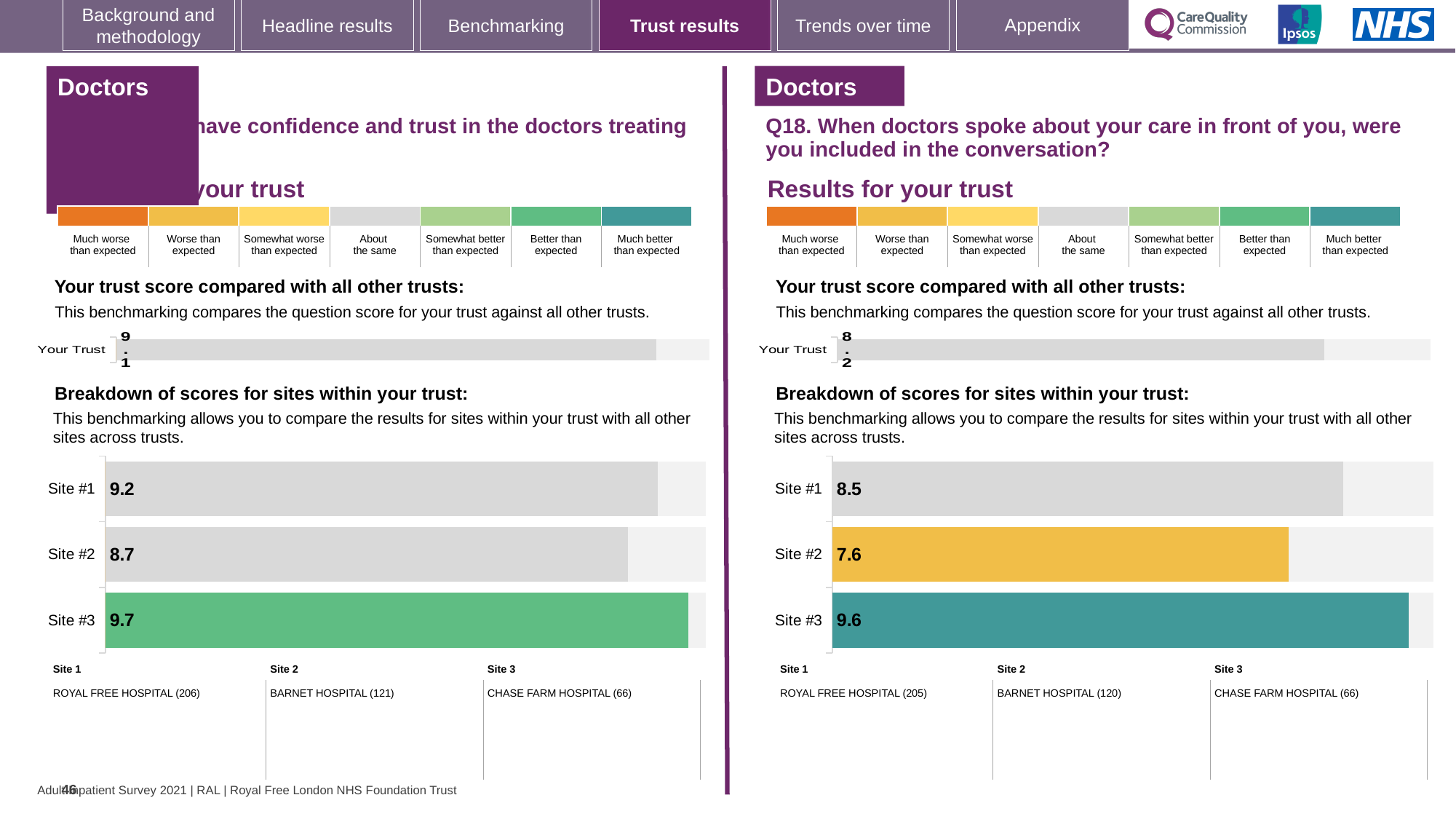
In the left-hand site breakdown chart, what is the difference between the scores for Site #1 and Site #2? 0.5 In the left-hand 'Your trust score compared with all other trusts' chart, what is the score for Your Trust? 9.1 How many sites are shown in the Q18 site breakdown chart on the right? 3 In the left-hand site breakdown chart, which is larger: the score for Site #1 or Site #3? Site #3 In the Q18 site breakdown chart on the right, what is the difference between the scores for Site #3 and Site #2? 2.0 In the Q18 site breakdown chart on the right, which site has the highest score? Site #3 What type of chart is used for the site breakdown on the right-hand side of the slide? Bar chart In the Q18 site breakdown chart on the right, what is the score for Site #2? 7.6 In the left-hand site breakdown chart, what is the score for Site #3? 9.7 In the Q18 site breakdown chart on the right, what colour is the bar for Site #2? Yellow In the left-hand site breakdown chart, which site has the lowest score? Site #2 In the Q18 'Your trust score compared with all other trusts' chart on the right, what is the score for Your Trust? 8.2